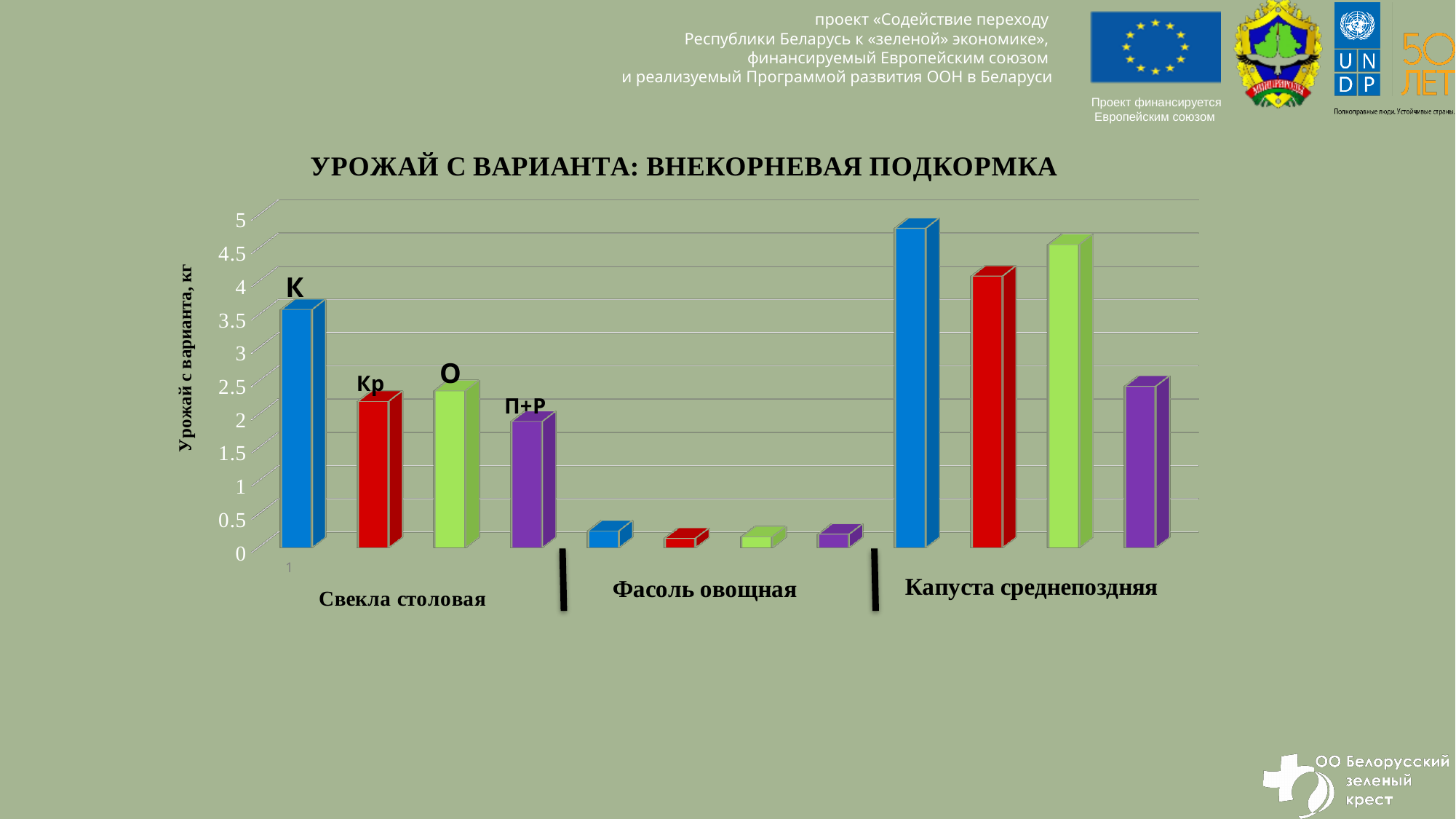
Which is larger: the yield for variant К of Свекла столовая or variant К of Капуста среднепоздняя? Капуста среднепоздняя Is the yield for variant П+Р of Свекла столовая greater or less than 2.5? less What is the title of the chart? УРОЖАЙ С ВАРИАНТА: ВНЕКОРНЕВАЯ ПОДКОРМКА Is the yield for variant К of Капуста среднепоздняя greater or less than 4? greater For Капуста среднепоздняя, which variant has the highest yield? К What kind of chart is shown on the slide? bar chart What is the label of the vertical axis? Урожай с варианта, кг Which crop group has the highest yields overall? Капуста среднепоздняя For Свекла столовая, which variant has the lowest yield? П+Р How many variants (series) are plotted for each crop? 4 Which crop group has the lowest yields overall? Фасоль овощная How many crop groups are shown along the x axis? 3